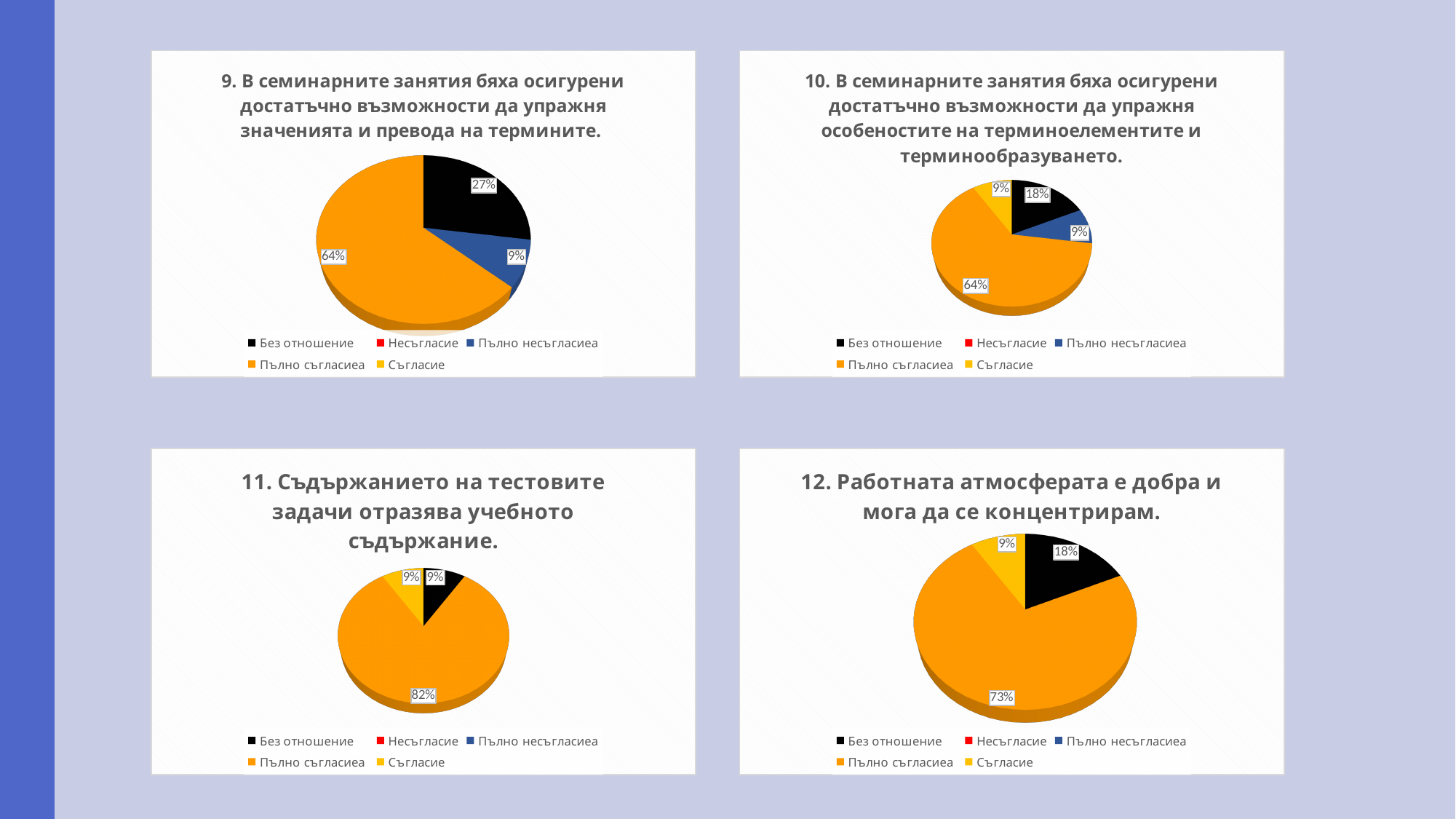
In the top-right chart (question 10), what share is labelled for Без отношение? 18% In the bottom-left chart (question 11), which is larger: the Пълно съгласиеа slice or the Съгласие slice? Пълно съгласиеа In the chart titled "9. В семинарните занятия бяха осигурени достатъчно възможности да упражня значенията и превода на термините.", what share is labelled for Без отношение? 27% In the top-right chart (question 10), how many slices are labelled with a percentage? 4 In the chart titled "11. Съдържанието на тестовите задачи отразява учебното съдържание.", what share is labelled for Пълно съгласиеа? 82% In the chart titled "12. Работната атмосферата е добра и мога да се концентрирам.", what share is labelled for Пълно съгласиеа? 73% In the chart titled "9. В семинарните занятия бяха осигурени достатъчно възможности да упражня значенията и превода на термините.", what share is labelled for Пълно съгласиеа? 64% How many entries does the legend of the bottom-right chart (question 12) list? 5 In the bottom-right chart (question 12), what is the difference between the Без отношение share and the Съгласие share? 9% In the top-right chart (question 10), which category has the largest slice? Пълно съгласиеа What type of chart is used for question 9 in the top-left of the slide? Pie chart In the top-left chart (question 9), what is the difference between the Пълно съгласиеа share and the Без отношение share? 37%